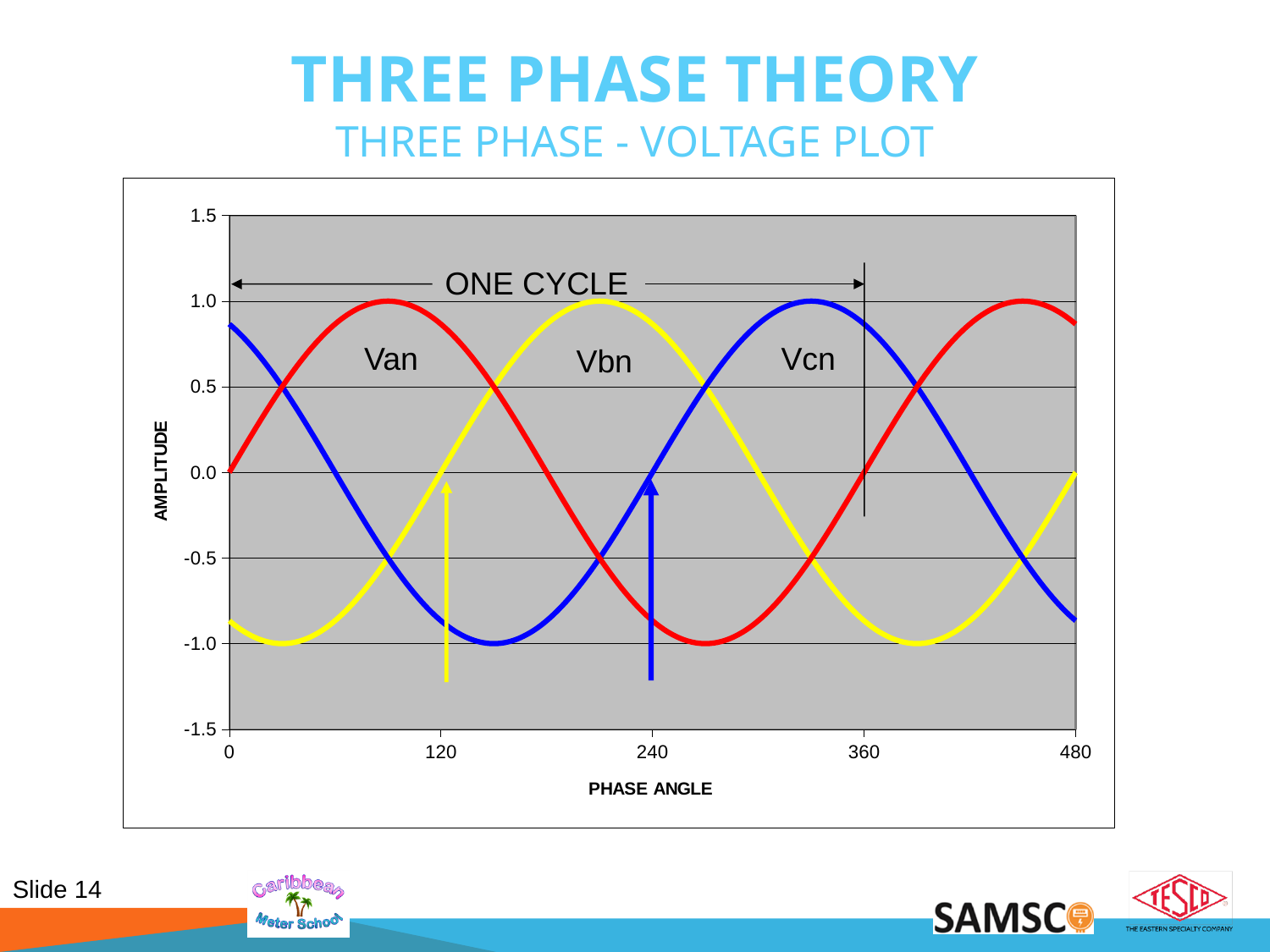
At a phase angle of 0, which waveform has the larger amplitude, Van or Vcn? Vcn What colour is the Vbn waveform? yellow What is the label of the x axis? PHASE ANGLE What is the amplitude of Van at a phase angle of 0? 0.0 Is the amplitude of Vbn at a phase angle of 0 greater or less than -0.5? less What kind of chart is shown on the slide? line chart What is the amplitude of Vbn at a phase angle of 120? 0.0 What is the amplitude of Vcn at a phase angle of 240? 0.0 What is the minimum amplitude reached by the Vbn waveform? -1.0 How many waveforms are plotted on the chart? 3 What is the maximum amplitude reached by the Van waveform? 1.0 Is the amplitude of Van at a phase angle of 120 greater or less than 0.5? greater